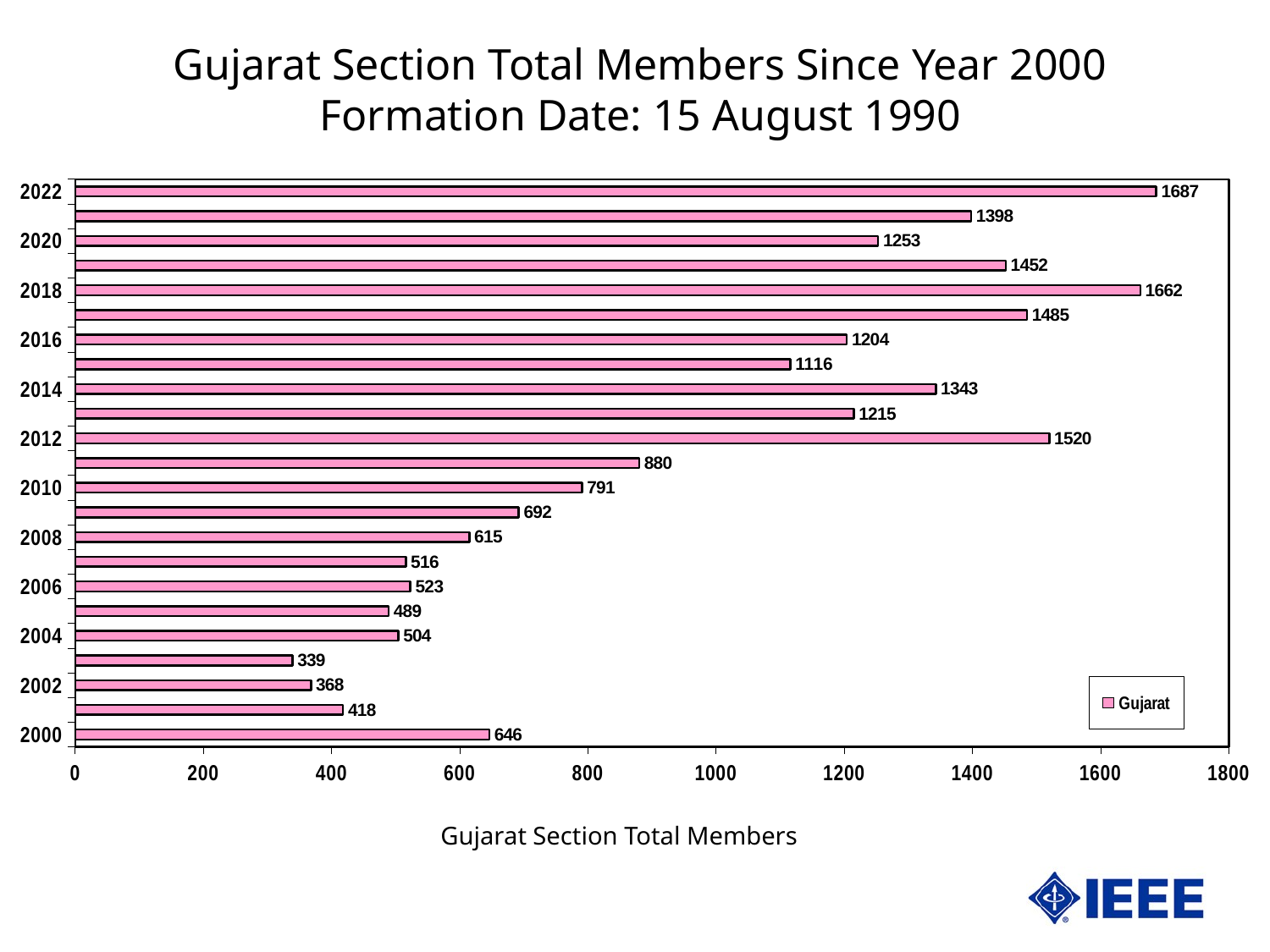
What is the difference between the values for 2022 and 2020? 434 What is the value for 2006? 523 What is the difference between the values for 2012 and 2010? 729 Which is larger, the value for 2018 or the value for 2016? 2018 What is the value for 2012? 1520 What is the only entry in the legend? Gujarat How many bars are shown on the chart? 23 What is the value for 2022? 1687 Which year has the highest value? 2022 What kind of chart is shown? Bar chart What is the value for 2000? 646 What is the lowest value shown on the chart? 339